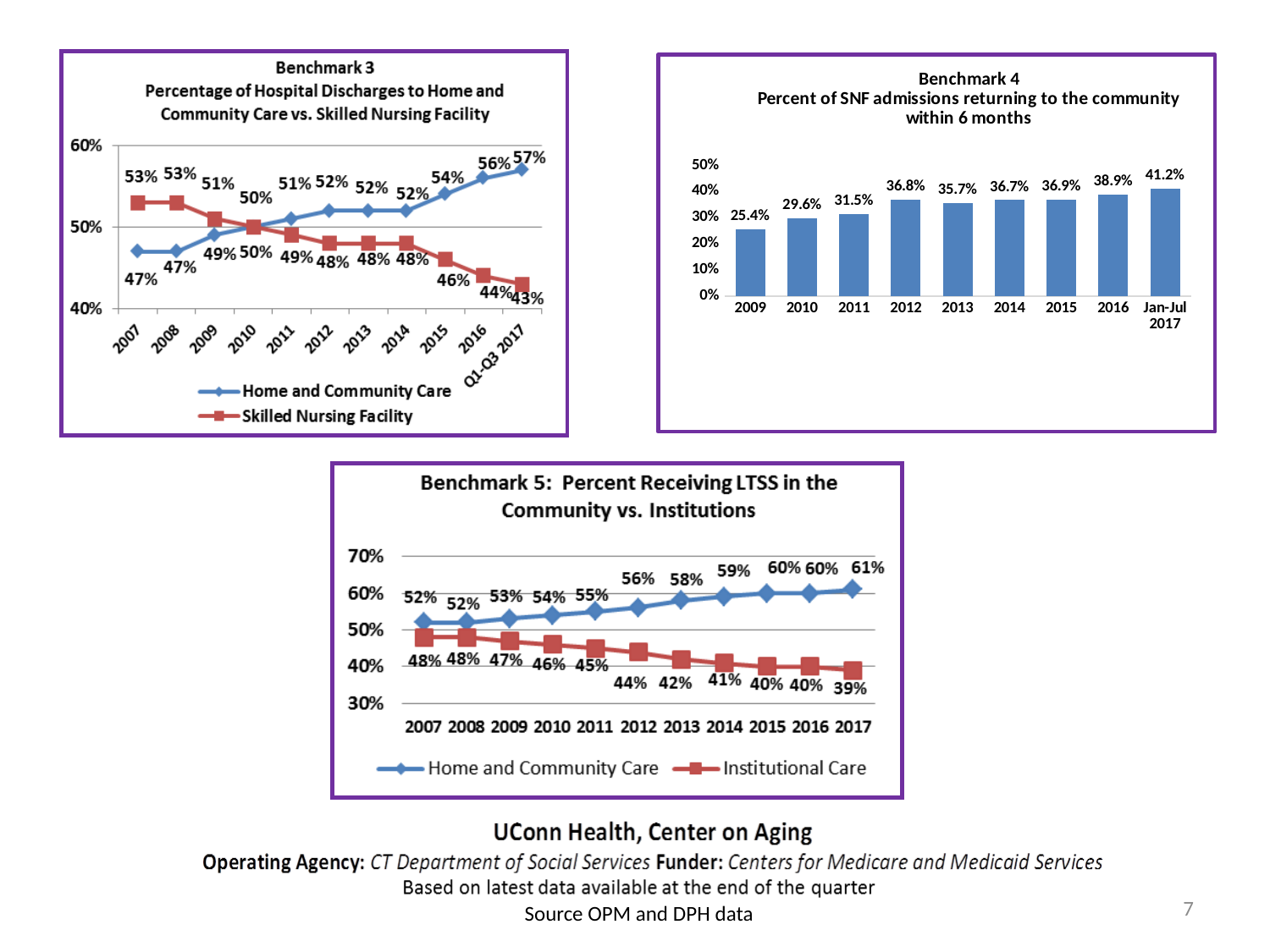
In the Benchmark 3 chart, does the Skilled Nursing Facility series rise or fall from 2007 to Q1-Q3 2017? Fall In the Benchmark 5 chart, what is the difference between the Home and Community Care and Institutional Care values in 2017? 22% In the Benchmark 3 chart, how many series does the legend list? 2 In the Benchmark 5 chart, what is the Institutional Care value for 2017? 39% In the Benchmark 4 chart, what is the value for 2009? 25.4% In the Benchmark 3 chart, what is the Home and Community Care value for Q1-Q3 2017? 57% In the Benchmark 4 chart, which year has the highest value? Jan-Jul 2017 In the Benchmark 4 chart, what is the difference between the 2016 value and the 2015 value? 2.0% In the Benchmark 5 chart, which series has the larger value in 2012, Home and Community Care or Institutional Care? Home and Community Care What kind of chart is the Benchmark 4 chart? Bar chart In the Benchmark 3 chart, what is the Skilled Nursing Facility value for 2016? 44% In the Benchmark 4 chart, how many bars are plotted? 9